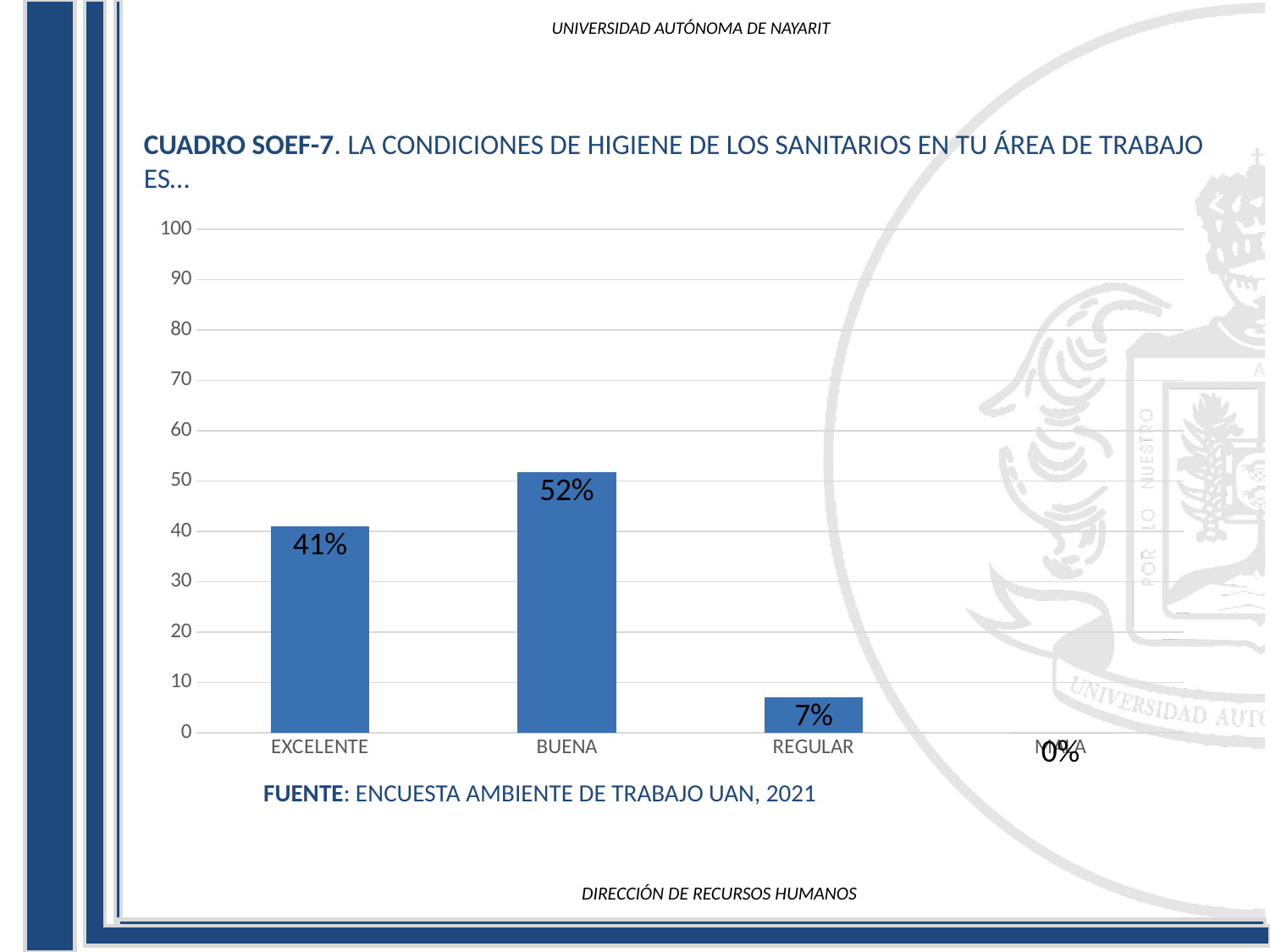
What source is cited below the chart? ENCUESTA AMBIENTE DE TRABAJO UAN, 2021 What is the value for BUENA? 52% Is the value for REGULAR greater or less than 10? less What is the value for REGULAR? 7% How many categories are shown on the x axis? 4 What is the difference between the values for BUENA and EXCELENTE? 11% What is the difference between the values for EXCELENTE and REGULAR? 34% Which is larger, the value for EXCELENTE or the value for REGULAR? EXCELENTE Which category has the highest value? BUENA What kind of chart is shown on the slide? bar chart What is the value for EXCELENTE? 41% Is the value for BUENA greater or less than 50? greater